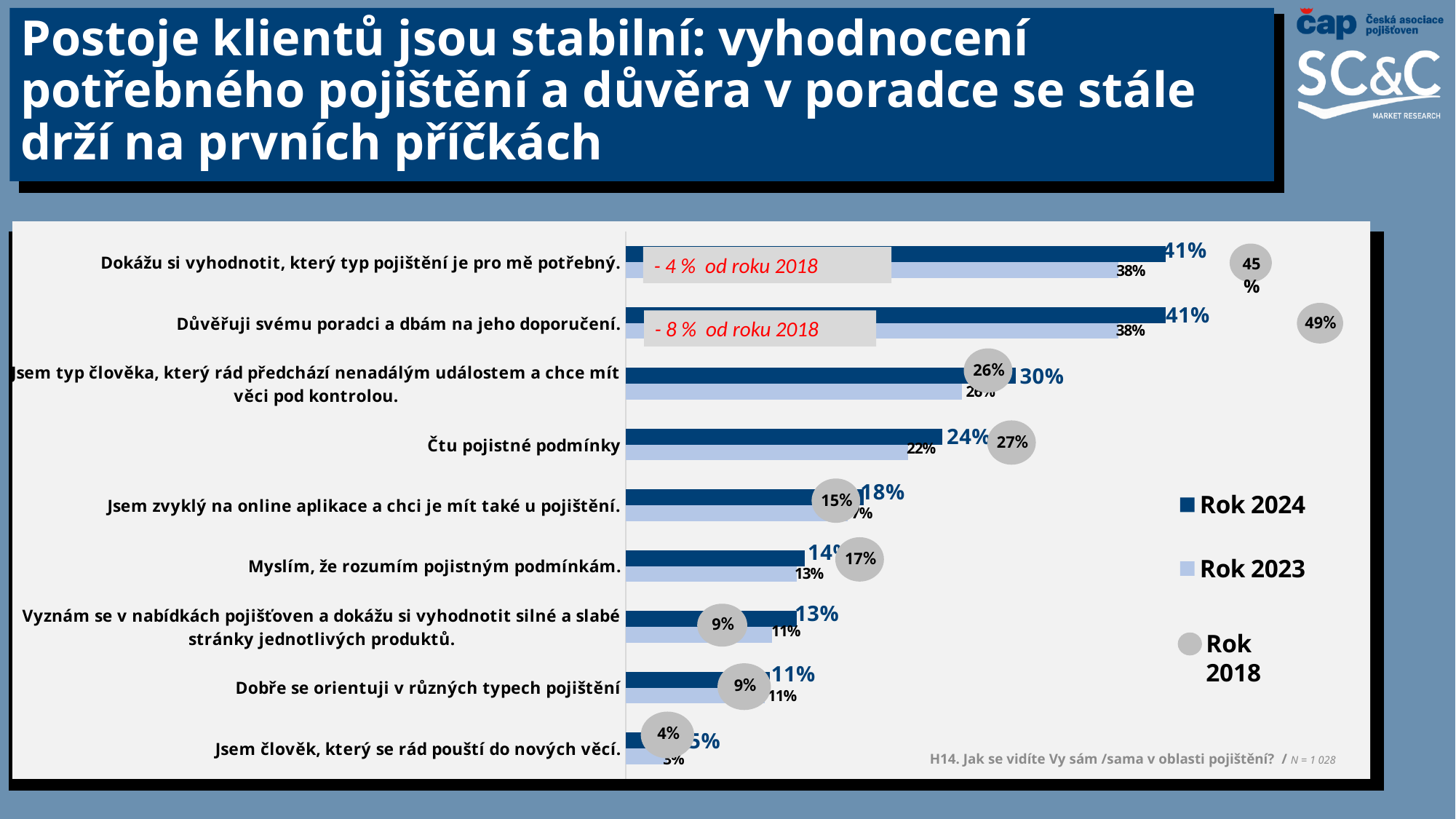
What is the Rok 2024 value for "Čtu pojistné podmínky"? 24% What is the difference between the Rok 2024 and Rok 2023 values for "Čtu pojistné podmínky"? 2% What kind of chart is shown on the slide? bar chart What is the difference between the Rok 2018 and Rok 2024 values for "Dokážu si vyhodnotit, který typ pojištění je pro mě potřebný."? 4% Which statement has the lowest Rok 2024 value? Jsem člověk, který se rád pouští do nových věcí. How many series does the chart legend list? 3 How many categories (statements) are plotted on the chart? 9 What is the Rok 2024 value for "Vyznám se v nabídkách pojišťoven a dokážu si vyhodnotit silné a slabé stránky jednotlivých produktů."? 13% For "Myslím, že rozumím pojistným podmínkám.", which is larger: the Rok 2018 value or the Rok 2023 value? Rok 2018 What is the Rok 2018 value for "Důvěřuji svému poradci a dbám na jeho doporučení."? 49% Which statement has the highest Rok 2018 value? Důvěřuji svému poradci a dbám na jeho doporučení. What is the Rok 2023 value for "Důvěřuji svému poradci a dbám na jeho doporučení."? 38%